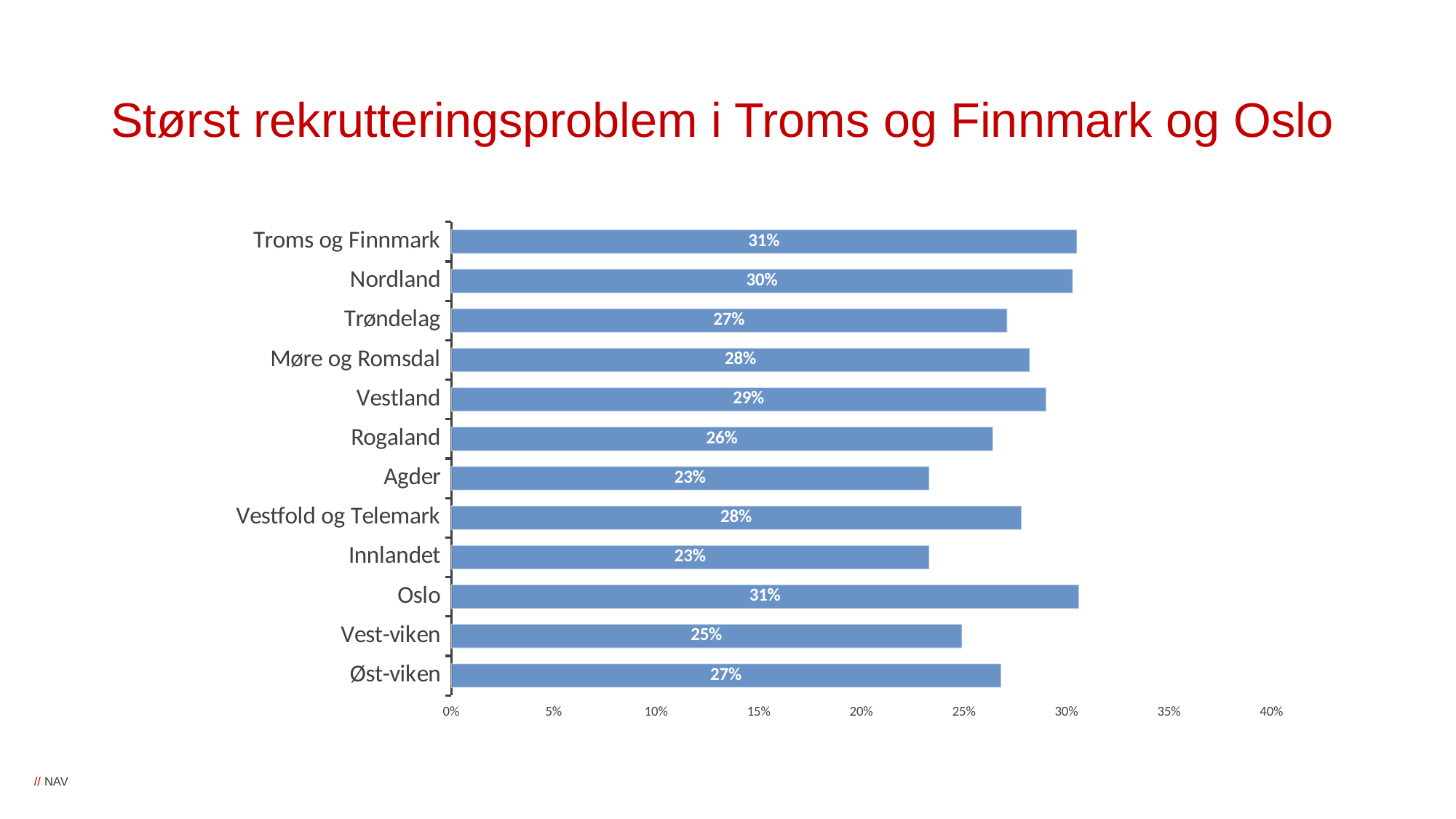
What kind of chart is shown on the slide? Bar chart Which has a larger value, Vestland or Rogaland? Vestland What is the value for Vest-viken? 25% What is the value for Nordland? 30% What is the difference between the values for Nordland and Rogaland? 4 percentage points What is the value for Agder? 23% What is the value for Vestfold og Telemark? 28% What is the difference between the values for Oslo and Innlandet? 8 percentage points Is the value for Vest-viken greater or less than 30%? less Which has a larger value, Trøndelag or Agder? Trøndelag How many regions are shown in the chart? 12 What is the value for Troms og Finnmark? 31%